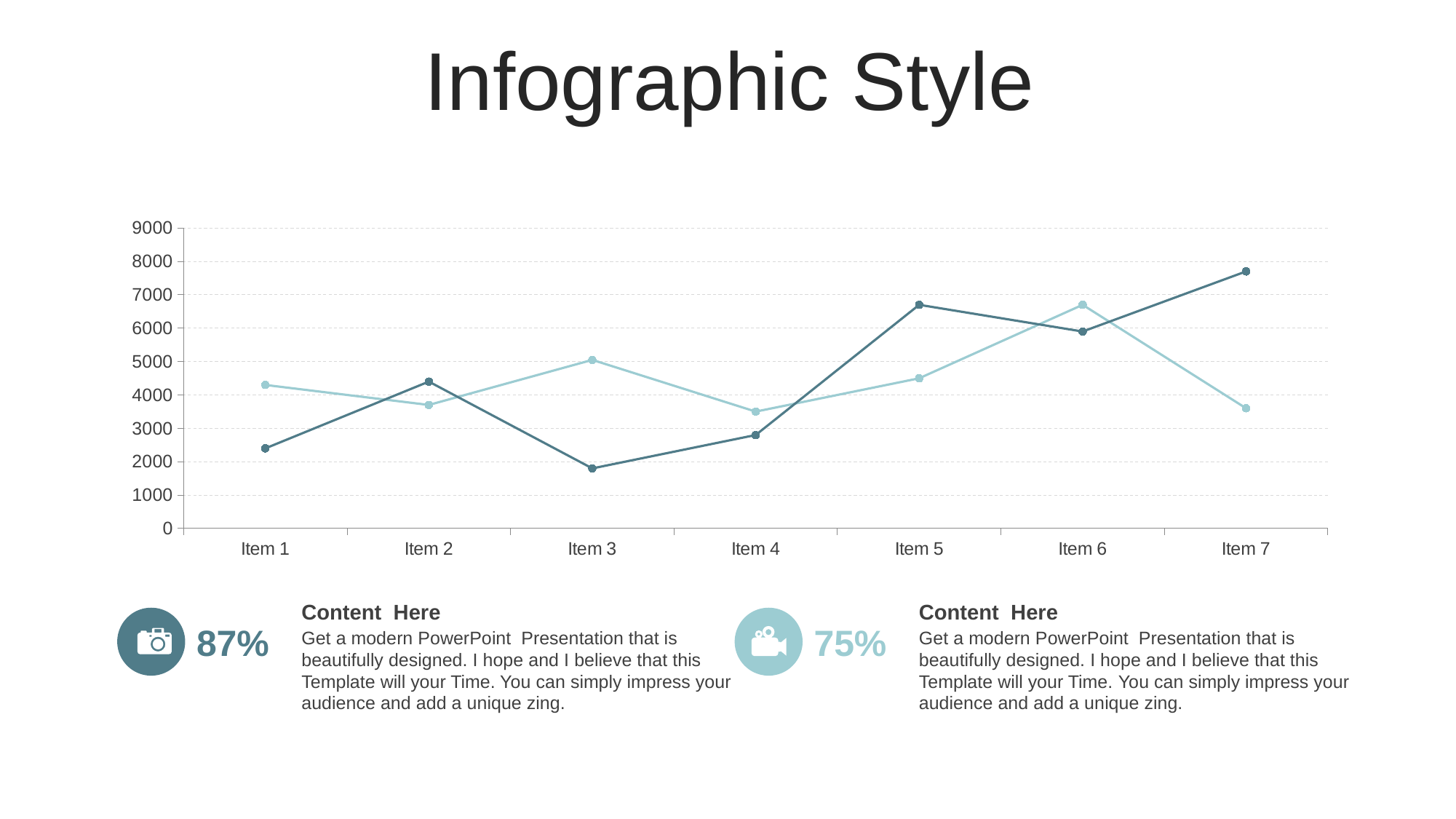
For the light line, which item has the highest value? Item 6 For the dark line, which item has the lowest value? Item 3 At Item 3, which line has the higher value, the dark line or the light line? the light line Is the dark line's value for Item 5 greater or less than 6000? greater How many categories are plotted along the x axis of the chart? 7 At Item 7, which line has the higher value, the dark line or the light line? the dark line For the dark line, which item has the highest value? Item 7 Is the dark line's value for Item 3 greater or less than 2000? less What kind of chart is shown on the slide? line chart How many lines (data series) are plotted on the chart? 2 Does the light line rise or fall from Item 6 to Item 7? fall Is the light line's value for Item 6 greater or less than 6000? greater